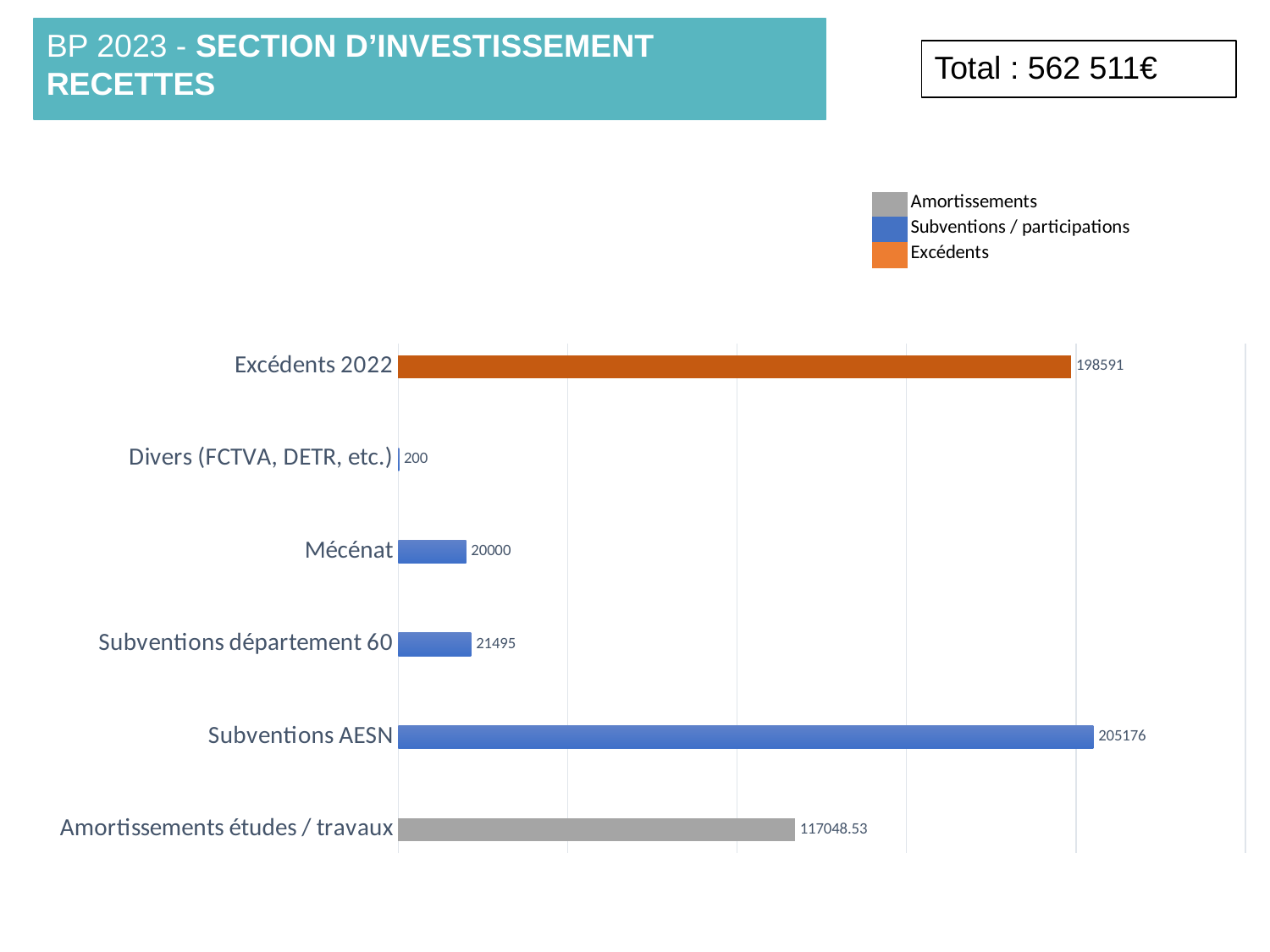
What kind of chart is shown on the slide? Bar chart What is the value for Mécénat? 20000 Which category has the lowest value? Divers (FCTVA, DETR, etc.) What is the value for Subventions AESN? 205176 What is the difference between the values for Subventions département 60 and Mécénat? 1495 How many categories are shown in the chart? 6 What is the difference between the values for Subventions AESN and Excédents 2022? 6585 How many series does the legend list? 3 Which category has the highest value? Subventions AESN What is the value for Excédents 2022? 198591 What is the value for Amortissements études / travaux? 117048.53 Which is larger, the value for Subventions département 60 or the value for Mécénat? Subventions département 60